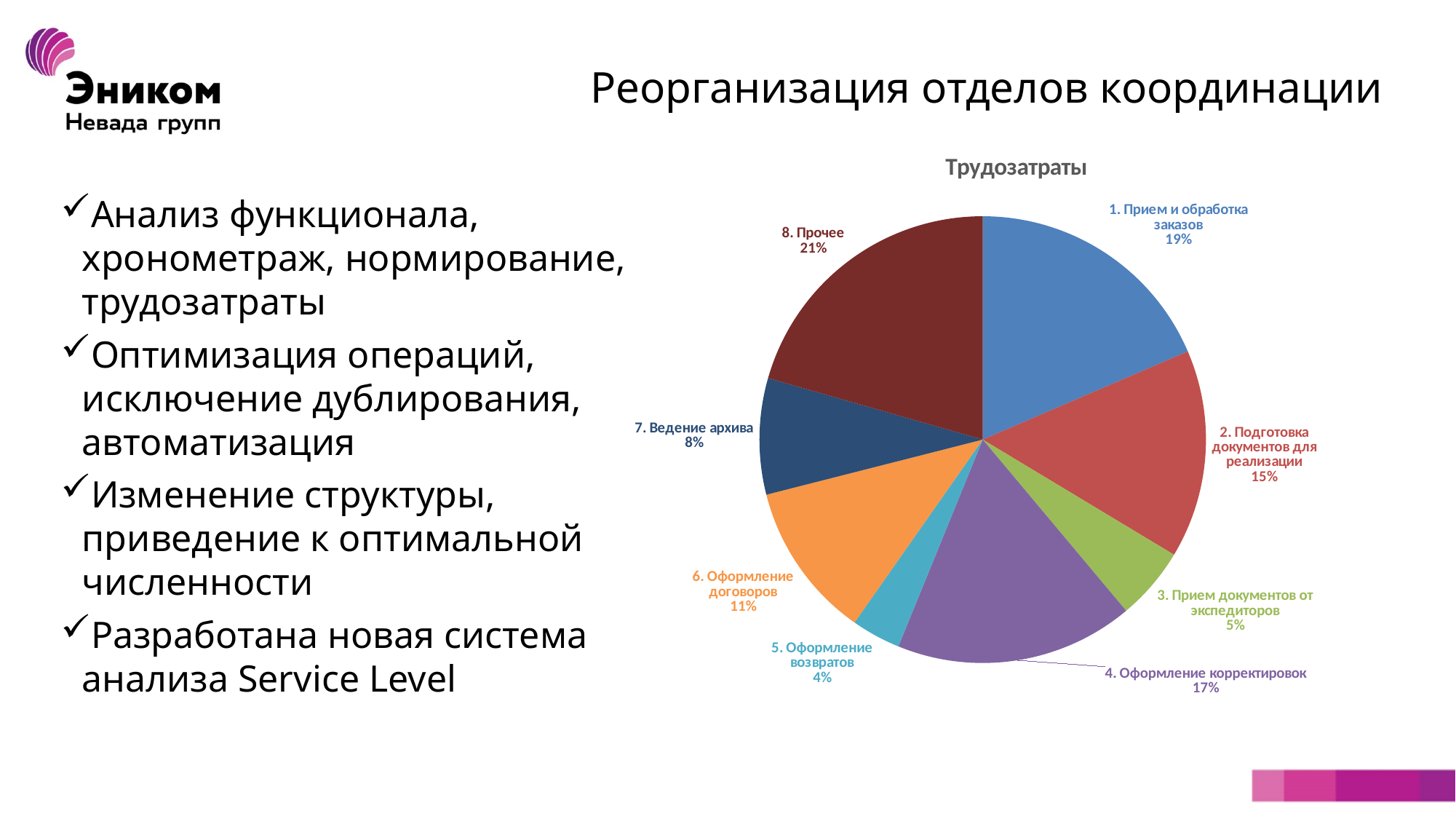
What is the value for "5. Оформление возвратов"? 4% Which category has the smallest share of the pie? 5. Оформление возвратов What is the title of the chart? Трудозатраты What is the combined share of "1. Прием и обработка заказов" and "2. Подготовка документов для реализации"? 34% What is the value for "7. Ведение архива"? 8% What is the difference between the shares of "4. Оформление корректировок" and "2. Подготовка документов для реализации"? 2% What share of the pie is "8. Прочее"? 21% How many slices does the pie chart have? 8 What kind of chart is shown on the slide? pie chart Which is larger: "6. Оформление договоров" or "3. Прием документов от экспедиторов"? 6. Оформление договоров What is the value for "1. Прием и обработка заказов"? 19% Which category has the largest share of the pie? 8. Прочее